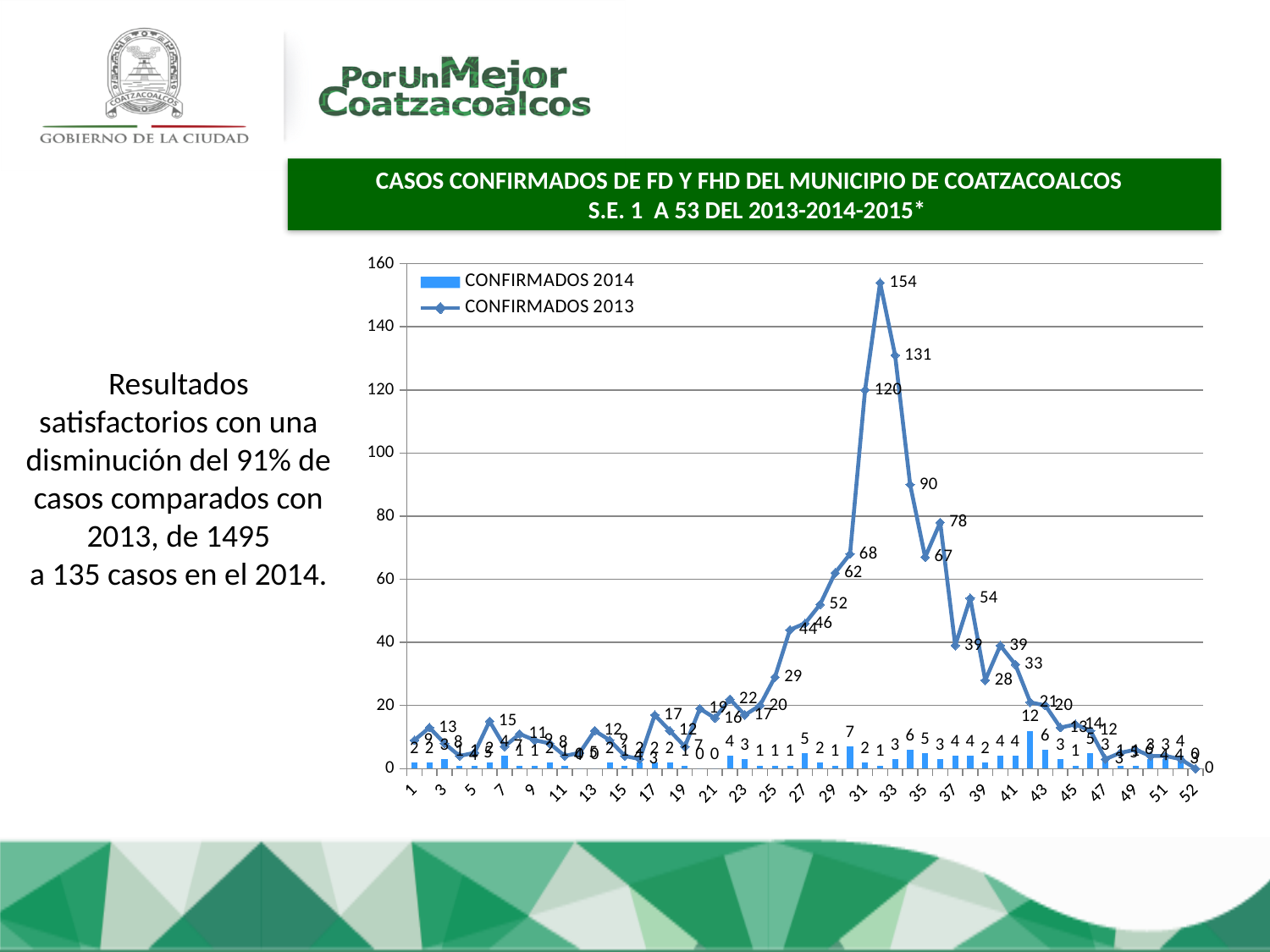
Is the peak value of the CONFIRMADOS 2013 line greater or less than 140? greater Does the CONFIRMADOS 2013 line rise or fall from its peak at week 32 to week 52? fall What is the highest value among the CONFIRMADOS 2014 bars? 12 What kind of chart is shown? A combined bar and line chart How many series does the legend list? 2 Which series reaches a higher maximum value, CONFIRMADOS 2013 or CONFIRMADOS 2014? CONFIRMADOS 2013 Which series is drawn as bars rather than a line? CONFIRMADOS 2014 What is the difference between the peak of the CONFIRMADOS 2013 line (154) and the next point (131)? 23 What is the maximum value shown on the vertical axis? 160 What are the two series named in the legend? CONFIRMADOS 2014 and CONFIRMADOS 2013 What is the value of the CONFIRMADOS 2013 line at week 52, the last point? 0 What is the highest value reached by the CONFIRMADOS 2013 line? 154